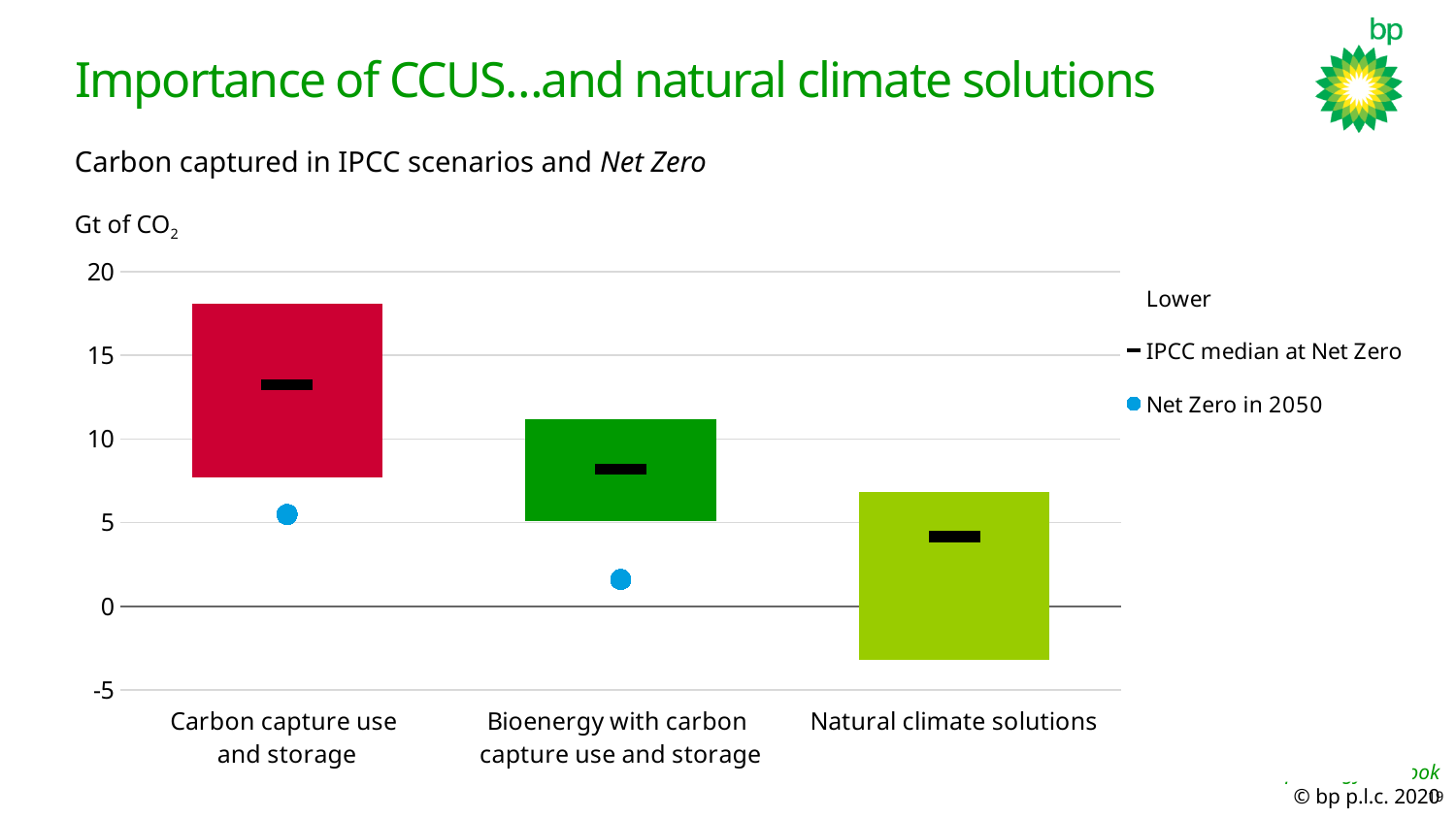
Is the IPCC median at Net Zero for Carbon capture use and storage greater or less than 10? greater Which category has the lowest IPCC median at Net Zero? Natural climate solutions What is the subtitle of the chart? Carbon captured in IPCC scenarios and Net Zero How many categories are shown on the x axis? 3 Is the Net Zero in 2050 value for Bioenergy with carbon capture use and storage greater or less than 5? less Which is larger, the Net Zero in 2050 value for Carbon capture use and storage or for Bioenergy with carbon capture use and storage? Carbon capture use and storage Which category has the highest IPCC median at Net Zero? Carbon capture use and storage How many entries does the legend list? 3 Do the IPCC median at Net Zero values rise or fall from left to right across the categories? fall What kind of chart is shown on the slide? bar chart What unit is the y axis measured in? Gt of CO2 Is the IPCC median at Net Zero for Natural climate solutions greater or less than 5? less